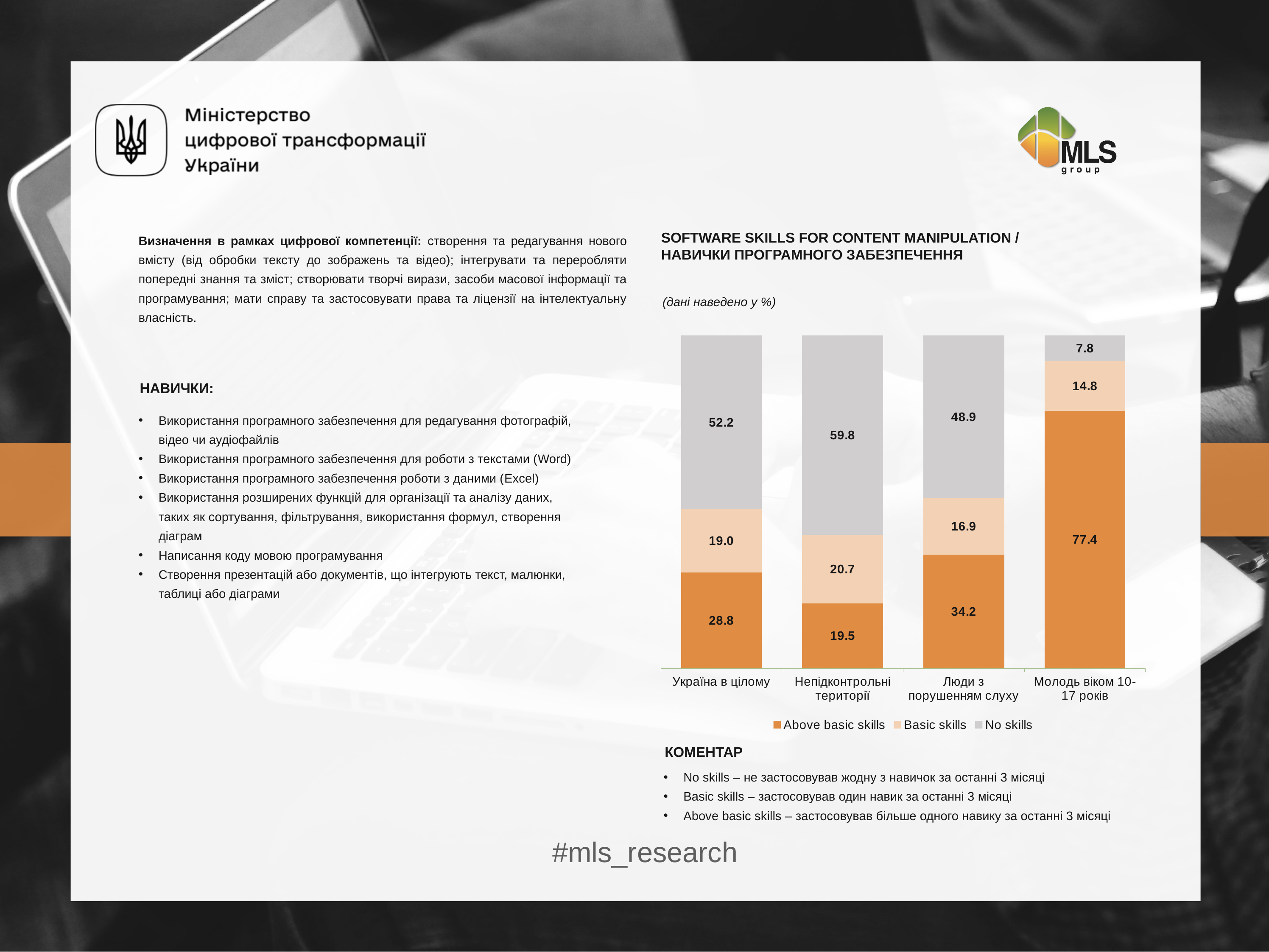
How many series does the chart legend list? 3 Which is larger: the "Basic skills" value for Непідконтрольні території or for Молодь віком 10-17 років? Непідконтрольні території How many categories are shown on the x axis of the chart? 4 What kind of chart is shown on the slide? Stacked bar chart What is the difference between the "No skills" values for Непідконтрольні території and Україна в цілому? 7.6 What is the value for "Above basic skills" for Україна в цілому? 28.8 What is the value for "No skills" for Непідконтрольні території? 59.8 Which category has the highest value for "Above basic skills"? Молодь віком 10-17 років What is the value for "No skills" for Молодь віком 10-17 років? 7.8 What is the total of the stacked bar for Люди з порушенням слуху? 100.0 Which category has the lowest value for "Above basic skills"? Непідконтрольні території What is the value for "Basic skills" for Люди з порушенням слуху? 16.9